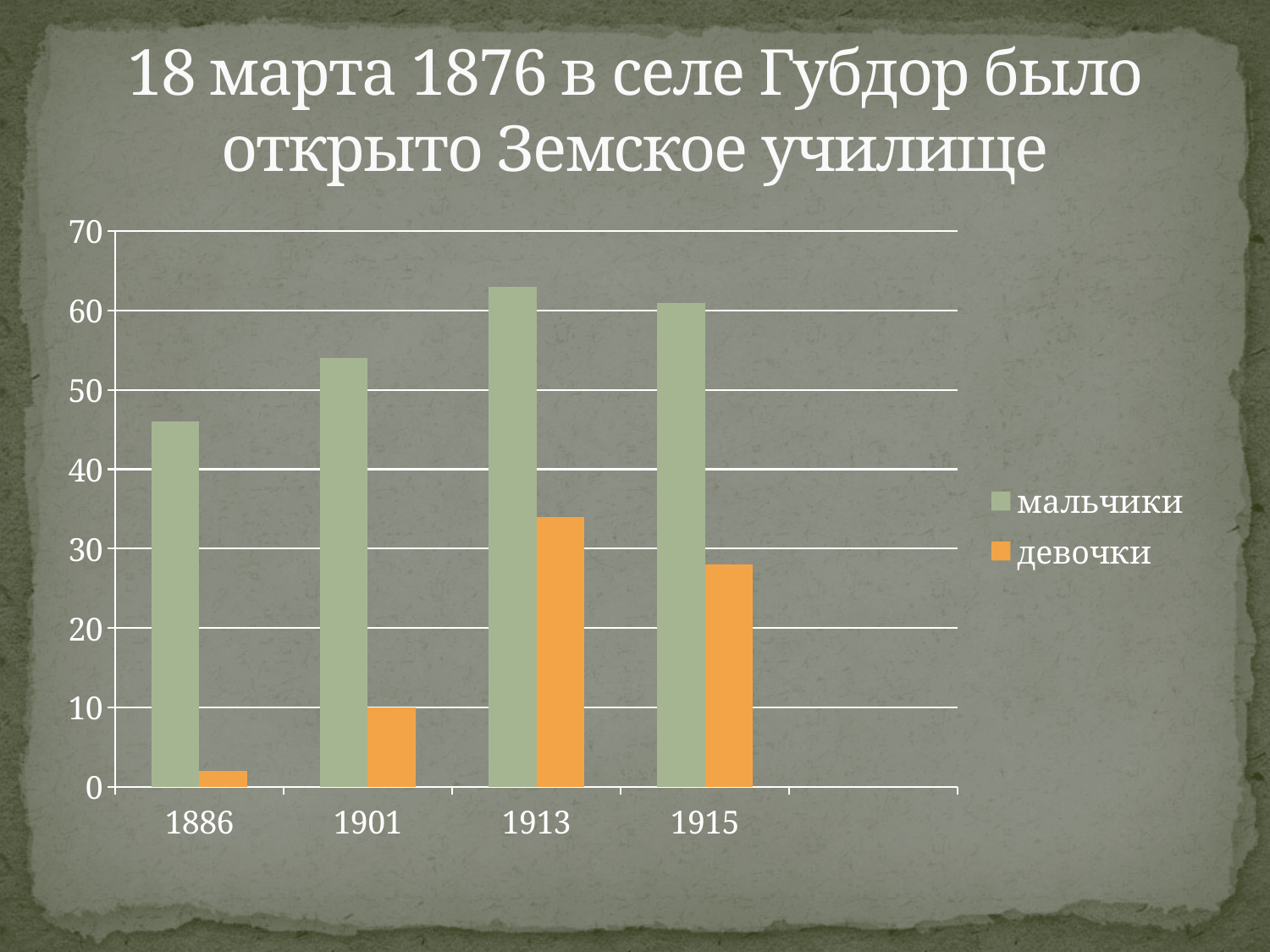
Is the value for мальчики in 1886 greater or less than 40? greater Do the values for мальчики rise or fall from 1886 to 1913? rise Is the value for девочки in 1915 greater or less than 30? less In which year is the value for девочки the lowest? 1886 How many series does the legend list? 2 What kind of chart is shown on the slide? bar chart Is the value for мальчики in 1913 greater or less than 60? greater How many years are shown on the x axis of the chart? 4 In which year is the value for девочки the highest? 1913 Which series is shown in orange in the legend? девочки In which year is the value for мальчики the lowest? 1886 In 1913, which is larger: мальчики or девочки? мальчики